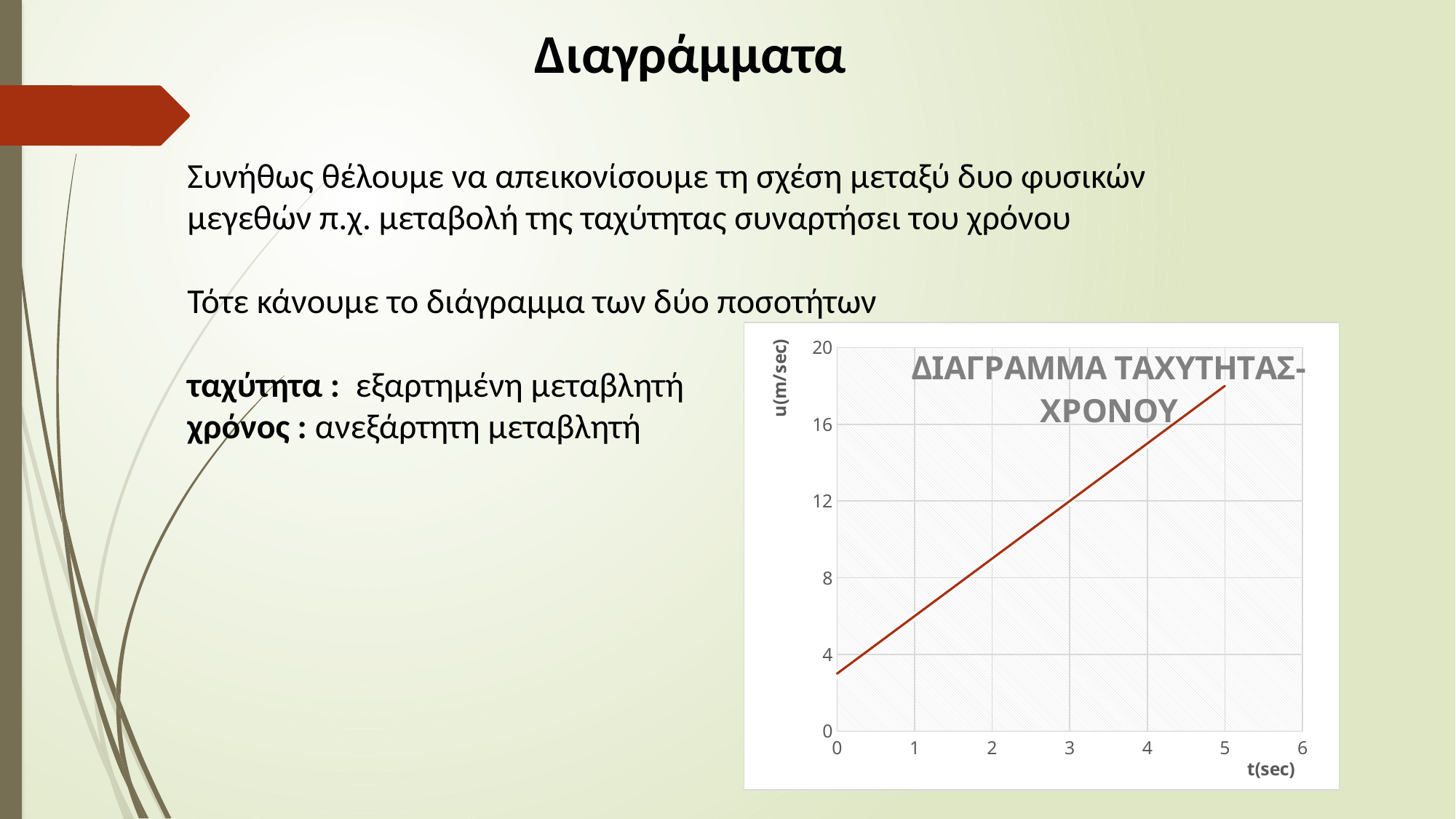
Is the value of u(m/sec) at t = 0 sec greater or less than 4? less Which is larger: the value of u(m/sec) at t = 1 sec or at t = 4 sec? t = 4 sec What kind of chart is shown on the slide? line chart Is the value of u(m/sec) at t = 1 sec greater or less than 8? less Is the value of u(m/sec) at t = 2 sec greater or less than 8? greater Does the plotted line rise or fall as t(sec) increases? rises What is the label of the vertical axis of the chart? u(m/sec) What is the highest tick value shown on the vertical axis of the chart? 20 What is the title of the chart on the slide? ΔΙΑΓΡΑΜΜΑ ΤΑΧΥΤΗΤΑΣ-ΧΡΟΝΟΥ